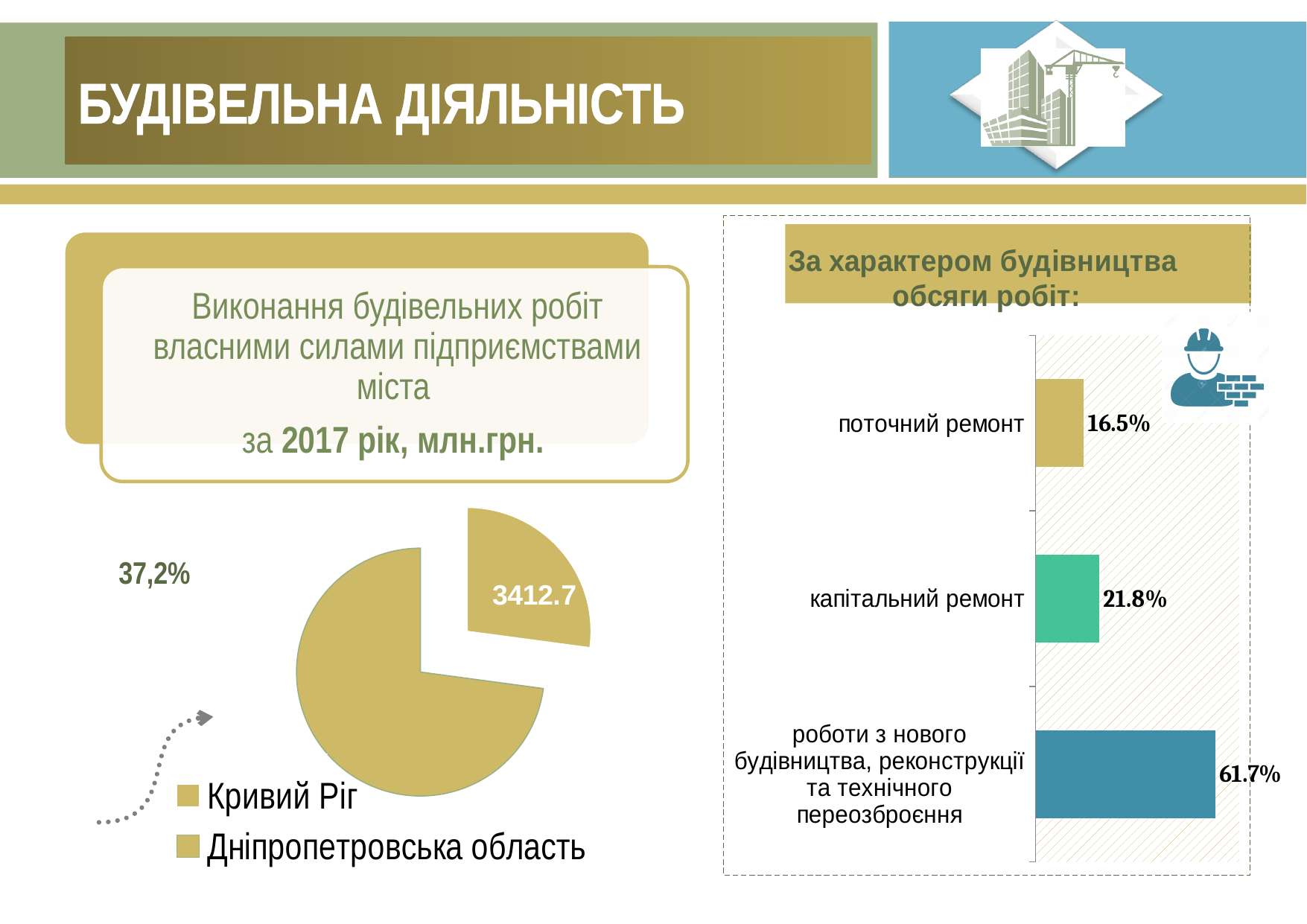
In the bar chart 'За характером будівництва обсяги робіт', what is the value for капітальний ремонт? 21.8% In the bar chart 'За характером будівництва обсяги робіт', which category has the highest value? роботи з нового будівництва, реконструкції та технічного переозброєння What kind of chart is the chart on the right side of the slide, 'За характером будівництва обсяги робіт'? bar chart In the bar chart 'За характером будівництва обсяги робіт', which category has the lowest value? поточний ремонт What kind of chart is the chart on the left side of the slide, under 'Виконання будівельних робіт власними силами підприємствами міста'? pie chart In the bar chart 'За характером будівництва обсяги робіт', what is the value for роботи з нового будівництва, реконструкції та технічного переозброєння? 61.7% In the bar chart 'За характером будівництва обсяги робіт', which is larger: капітальний ремонт or поточний ремонт? капітальний ремонт How many entries does the legend of the pie chart on the left side of the slide list? 2 In the pie chart on the left side of the slide, what value is printed on the exploded slice? 3412.7 In the bar chart 'За характером будівництва обсяги робіт', what is the difference between капітальний ремонт and поточний ремонт? 5.3% How many categories are shown in the bar chart 'За характером будівництва обсяги робіт'? 3 In the bar chart 'За характером будівництва обсяги робіт', what is the value for поточний ремонт? 16.5%